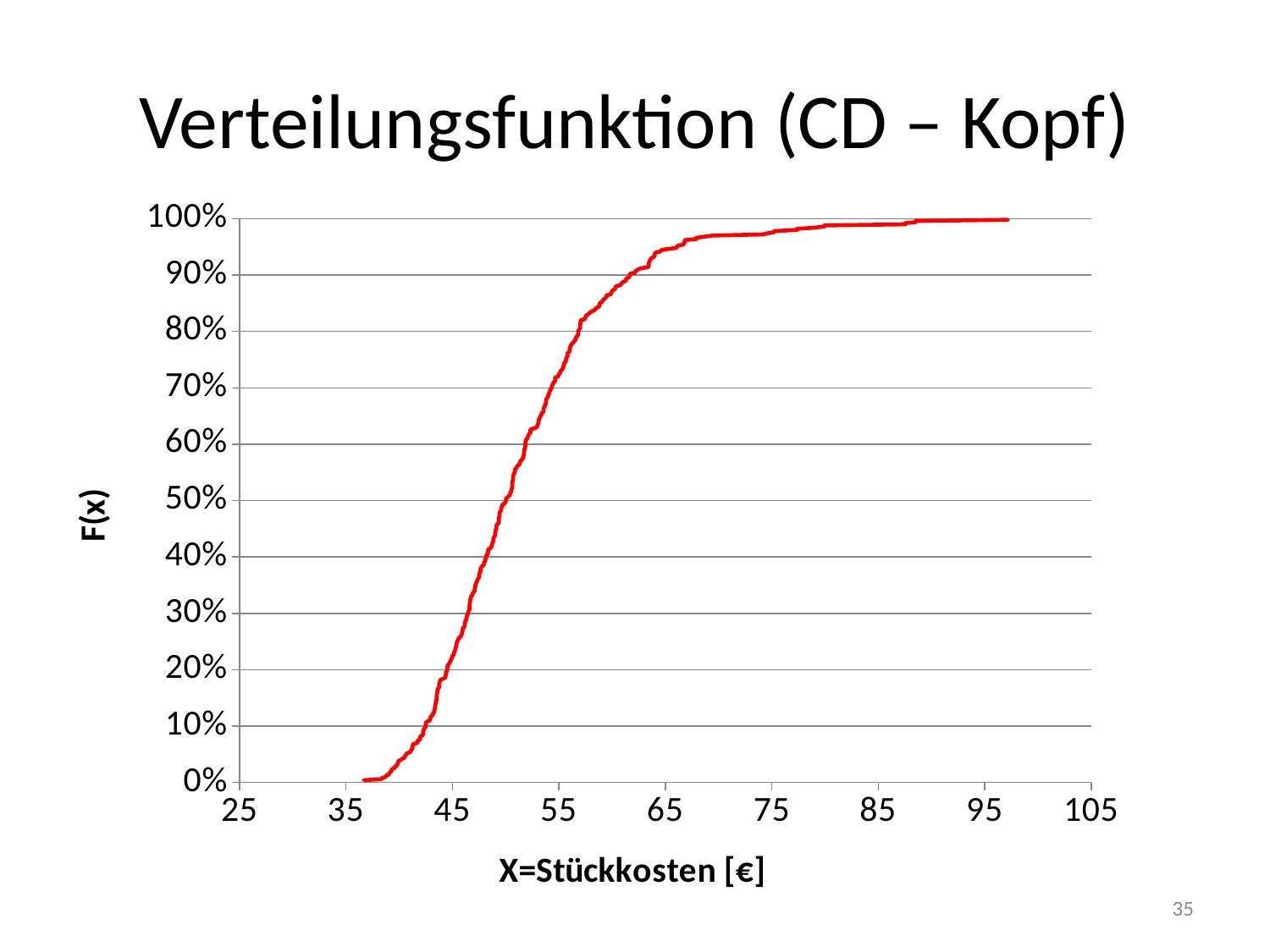
Is the value of F(x) at X = 65 greater or less than 80%? greater Is the value of F(x) at X = 75 greater or less than 90%? greater Is the value of F(x) at X = 55 greater or less than 60%? greater What is the title of the chart? Verteilungsfunktion (CD – Kopf) Does the plotted F(x) curve rise or fall as X increases along the x axis? rise What is the label of the x axis? X=Stückkosten [€] What kind of chart is shown on the slide? line chart